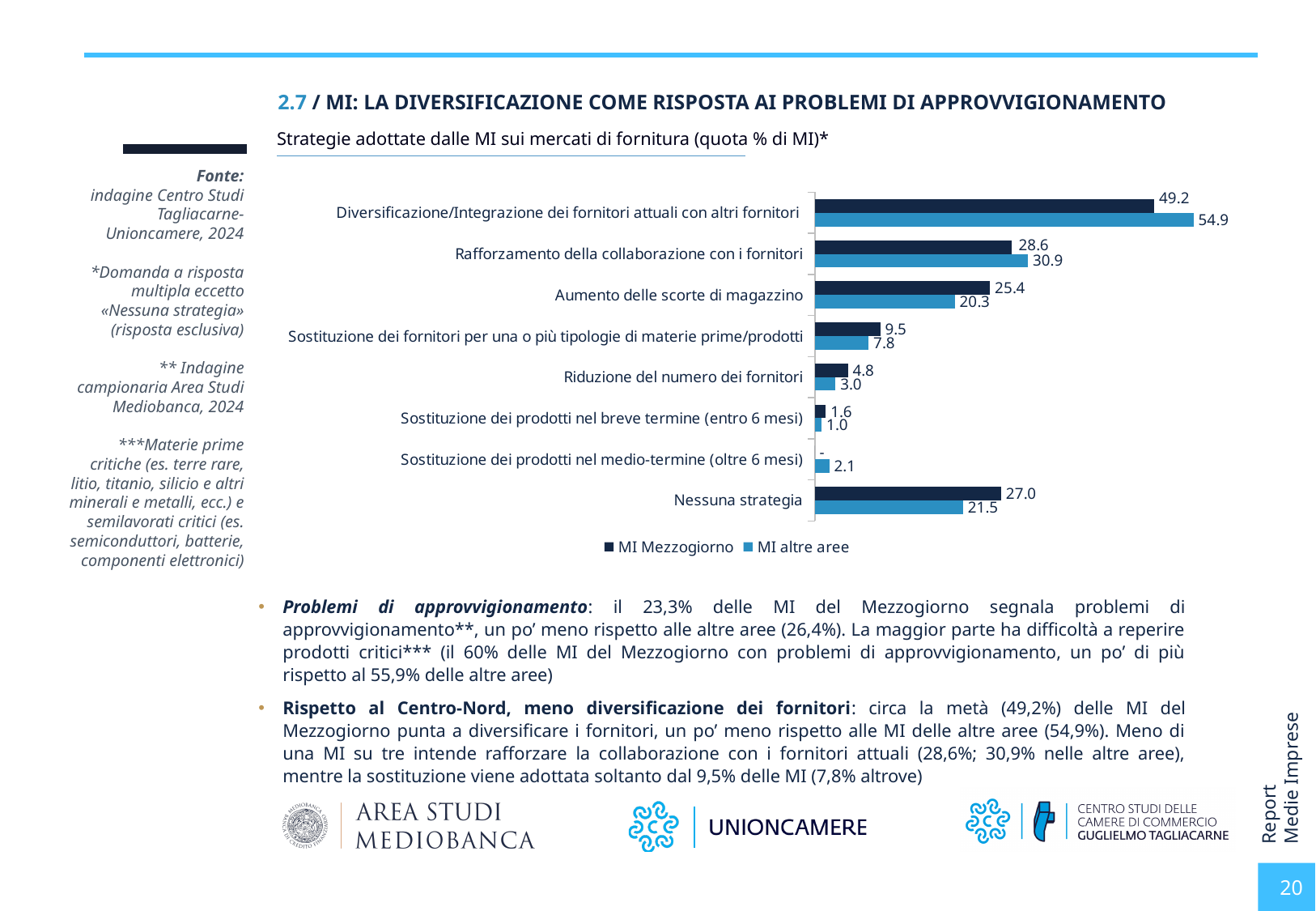
How many categories are shown in the chart? 8 What is the difference between MI altre aree and MI Mezzogiorno for "Diversificazione/Integrazione dei fornitori attuali con altri fornitori"? 5.7 Which category has the lowest value for MI altre aree? Sostituzione dei prodotti nel breve termine (entro 6 mesi) What is the value for MI altre aree for "Sostituzione dei prodotti nel medio-termine (oltre 6 mesi)"? 2.1 For "Riduzione del numero dei fornitori", which series has the larger value, MI Mezzogiorno or MI altre aree? MI Mezzogiorno For "Rafforzamento della collaborazione con i fornitori", which series has the larger value, MI Mezzogiorno or MI altre aree? MI altre aree How many series does the legend list? 2 What is the value for MI Mezzogiorno for "Diversificazione/Integrazione dei fornitori attuali con altri fornitori"? 49.2 What is the value for MI altre aree for "Aumento delle scorte di magazzino"? 20.3 What is the difference between MI Mezzogiorno and MI altre aree for "Nessuna strategia"? 5.5 Which category has the highest value for MI altre aree? Diversificazione/Integrazione dei fornitori attuali con altri fornitori What kind of chart is shown on the slide? Bar chart